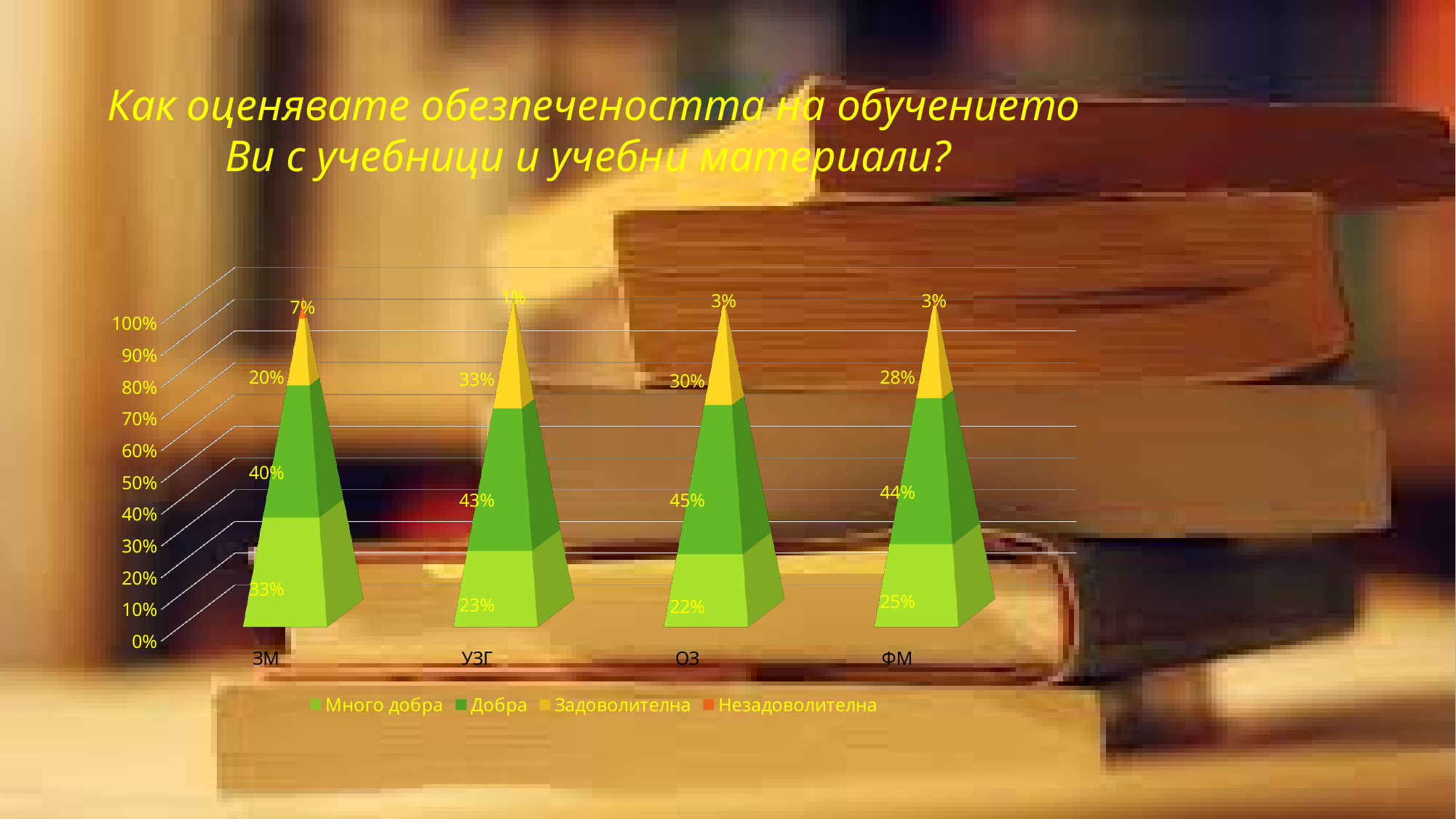
What is the value of Незадоволителна for ЗМ? 7% What is the difference between the Добра values for ОЗ and ЗМ? 5% What is the value of Добра for ОЗ? 45% What is the total of the stacked bar for ФМ? 100% Which is larger, the Задоволителна value for ОЗ or for ФМ? ОЗ What is the value of Много добра for ЗМ? 33% How many categories are shown on the x axis? 4 What is the value of Задоволителна for УЗГ? 33% What kind of chart is shown on the slide? Stacked bar chart How many series does the legend list? 4 Which category has the highest value for Много добра? ЗМ Which category has the lowest value for Незадоволителна? УЗГ